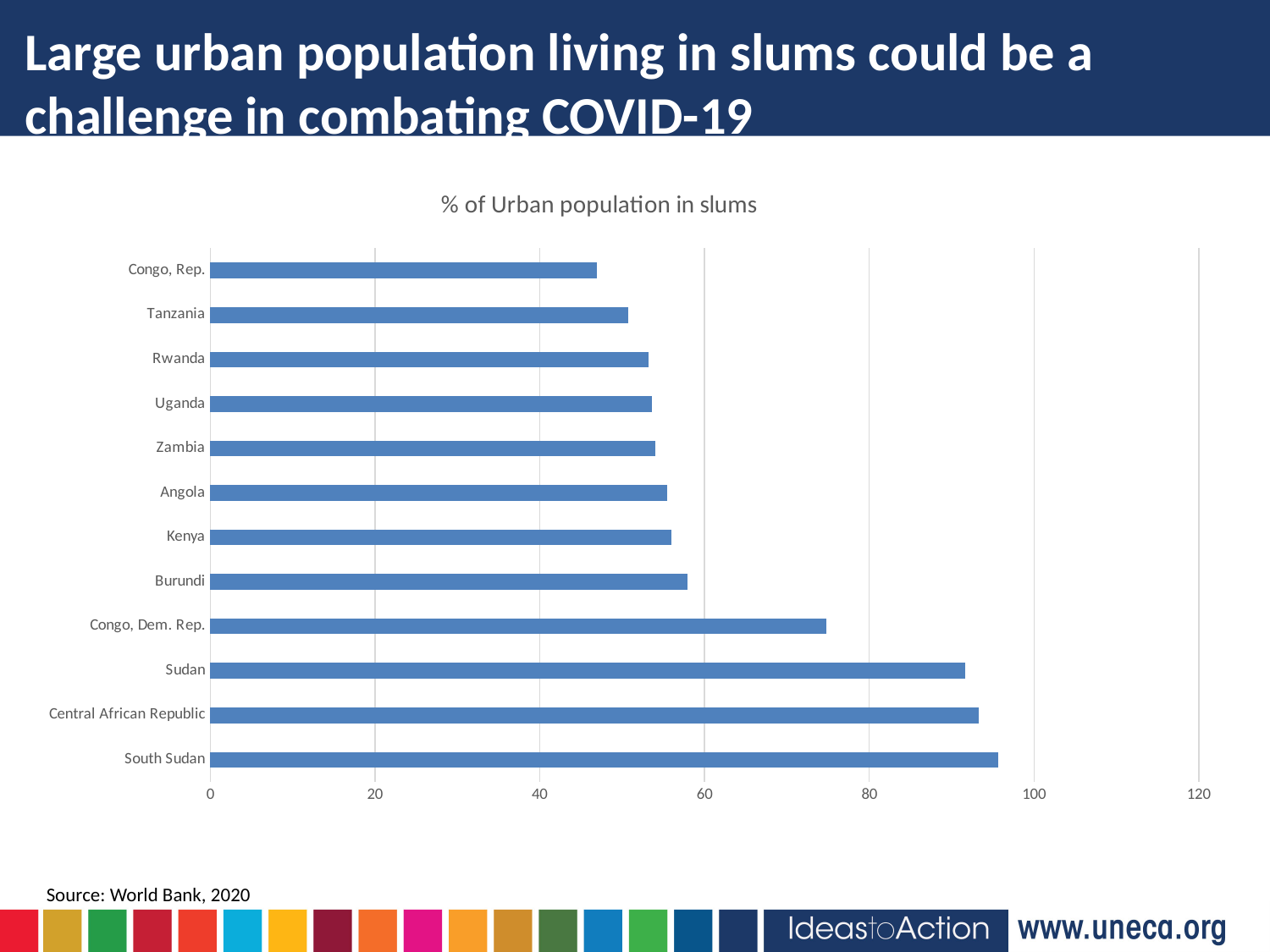
Which country has the highest % of urban population in slums? South Sudan What is the source cited for the chart data? World Bank, 2020 Is the value for Kenya greater or less than 40? greater How many countries are shown in the chart? 12 Is the value for Congo, Dem. Rep. greater or less than 80? less Is the value for Sudan greater or less than 80? greater Which country has the lowest % of urban population in slums? Congo, Rep. Which has a higher % of urban population in slums, Congo, Dem. Rep. or Burundi? Congo, Dem. Rep. Which has a higher % of urban population in slums, Sudan or Kenya? Sudan What kind of chart is shown on the slide? bar chart What is the title of the chart? % of Urban population in slums